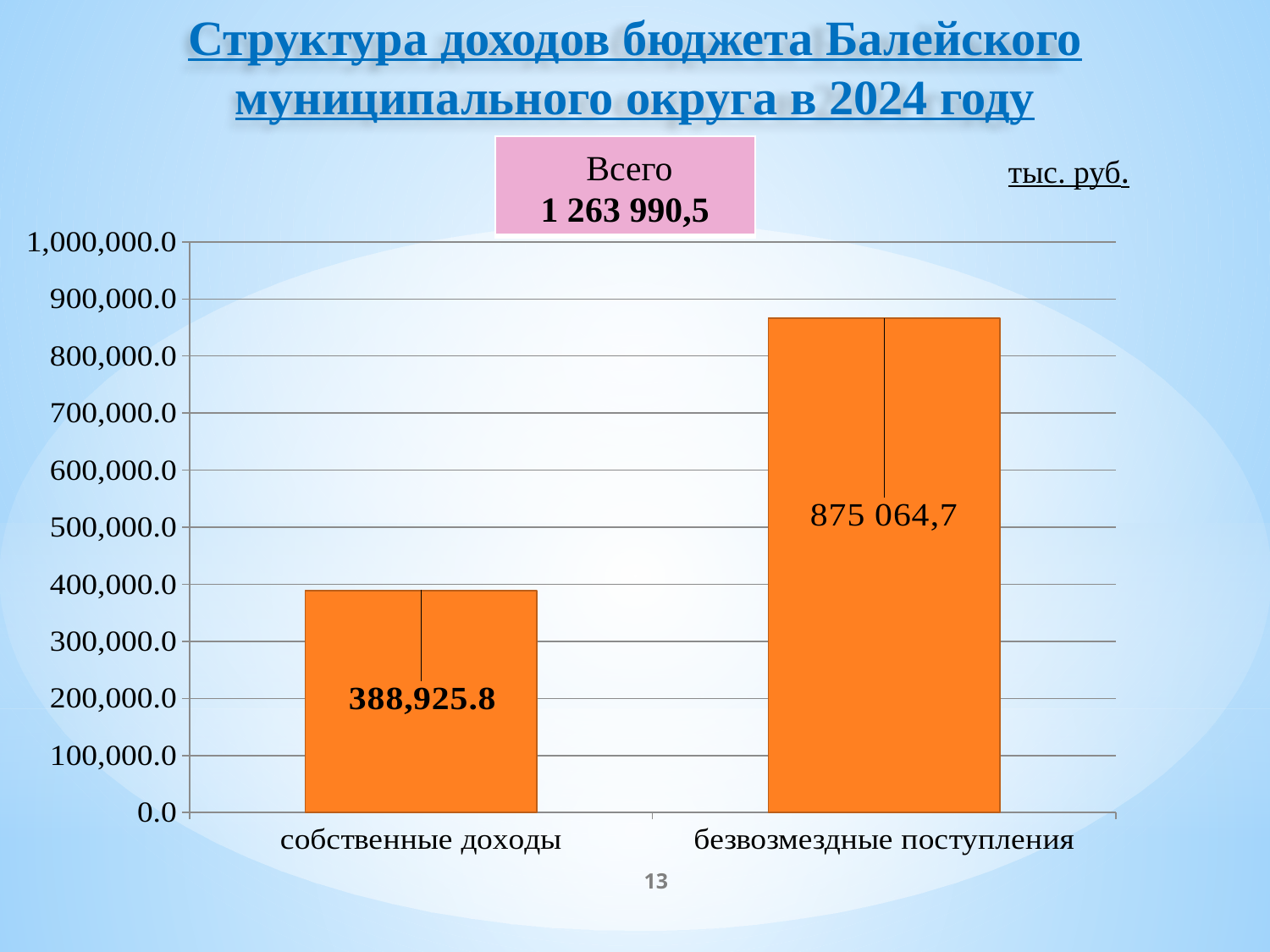
What unit of measurement is indicated on the slide? тыс. руб. What is the value for безвозмездные поступления? 875 064,7 What is the difference between безвозмездные поступления and собственные доходы? 486,138.9 Is the value for безвозмездные поступления greater or less than 800,000.0? greater What is the value for собственные доходы? 388,925.8 Which category has the lowest value? собственные доходы How many categories are shown on the x axis? 2 What total (Всего) is shown above the chart? 1 263 990,5 Which category has the highest value? безвозмездные поступления Is the value for собственные доходы greater or less than 400,000.0? less Which is larger, собственные доходы or безвозмездные поступления? безвозмездные поступления What kind of chart is shown on the slide? bar chart